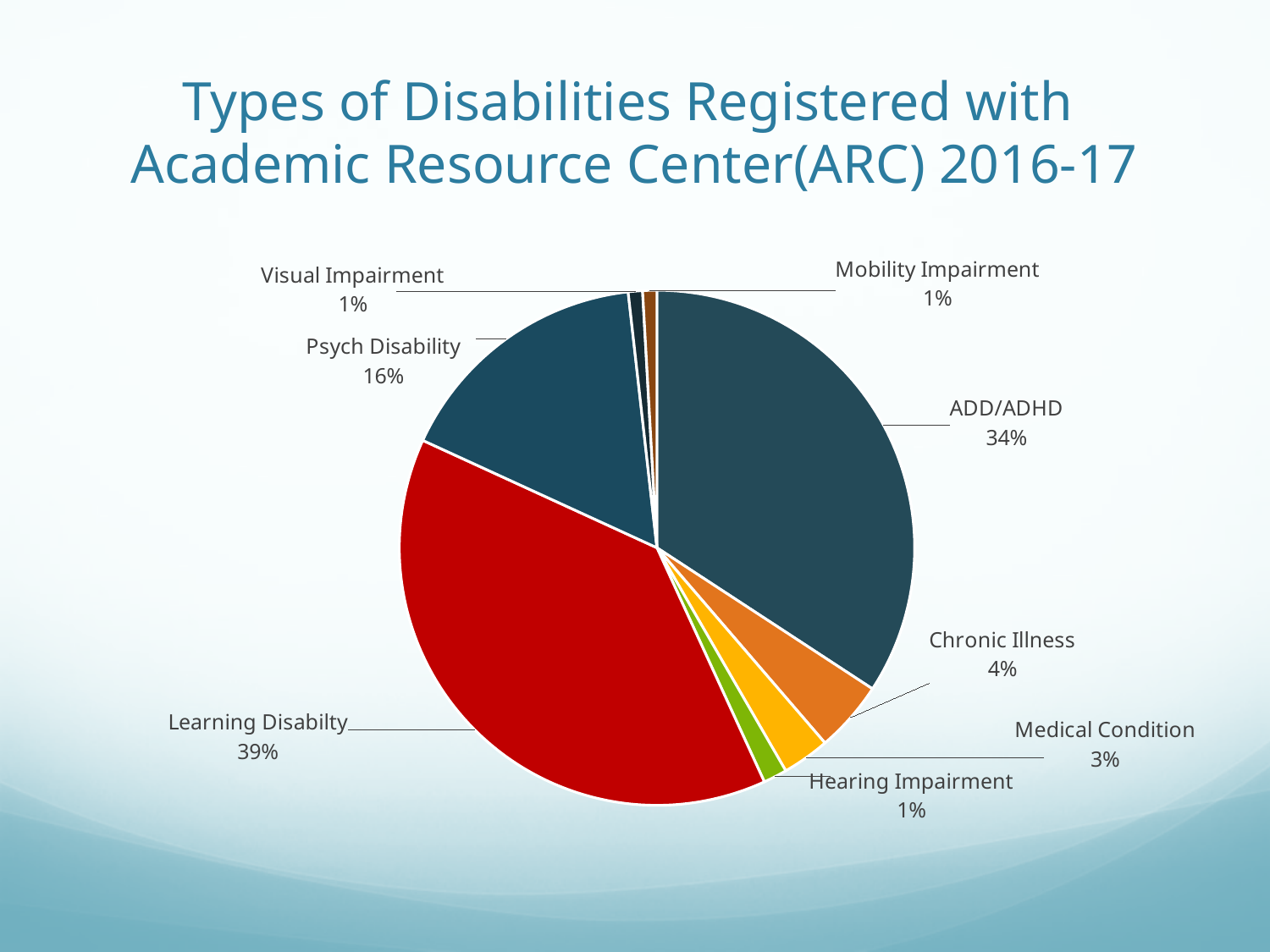
What kind of chart is shown on the slide? Pie chart What percentage is shown for ADD/ADHD? 34% What percentage is shown for Chronic Illness? 4% What share of the pie does Learning Disabilty account for? 39% What is the title of the chart on the slide? Types of Disabilities Registered with Academic Resource Center(ARC) 2016-17 What percentage is shown for Medical Condition? 3% How many categories are shown in the pie chart? 8 What is the difference in percentage points between Learning Disabilty and ADD/ADHD? 5 What percentage is shown for Psych Disability? 16% Which is larger, the share for Chronic Illness or the share for Medical Condition? Chronic Illness Which category has the largest slice of the pie? Learning Disabilty What is the difference in percentage points between ADD/ADHD and Psych Disability? 18